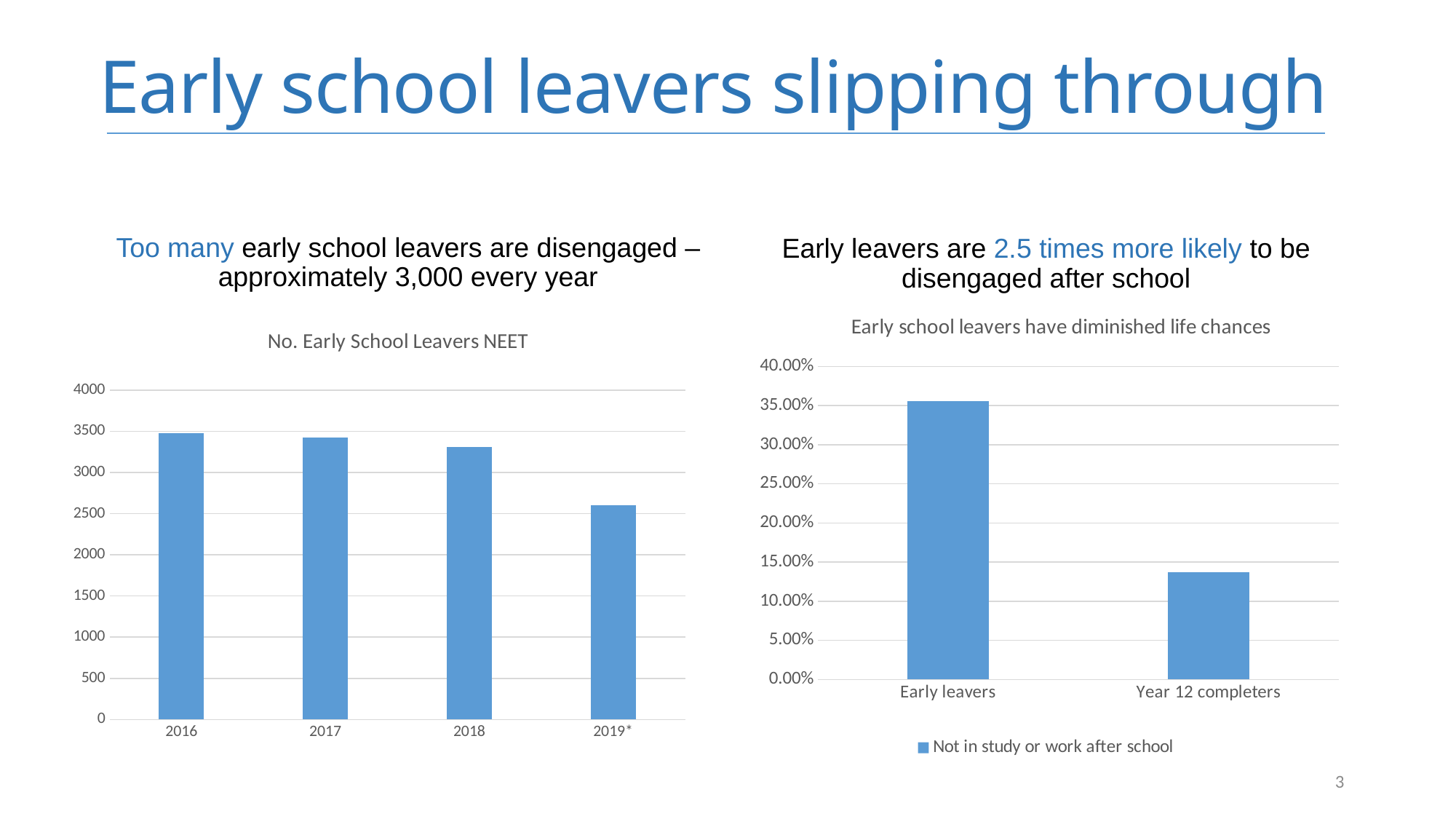
In the chart titled "Early school leavers have diminished life chances", what is the legend entry? Not in study or work after school In the chart titled "Early school leavers have diminished life chances", how many series does the legend list? 1 In the chart titled "No. Early School Leavers NEET", which year has the highest value? 2016 In the chart titled "No. Early School Leavers NEET", what kind of chart is shown? bar chart In the chart titled "No. Early School Leavers NEET", do the values rise or fall from 2016 to 2019*? fall In the chart titled "No. Early School Leavers NEET", which year has the lowest value? 2019* In the chart titled "No. Early School Leavers NEET", is the value for 2018 greater or less than 3000? greater In the chart titled "Early school leavers have diminished life chances", is the value for Year 12 completers greater or less than 15.00%? less In the chart titled "No. Early School Leavers NEET", how many years are plotted? 4 In the chart titled "Early school leavers have diminished life chances", which category has the higher value? Early leavers In the chart titled "No. Early School Leavers NEET", is the value for 2019* greater or less than 3000? less